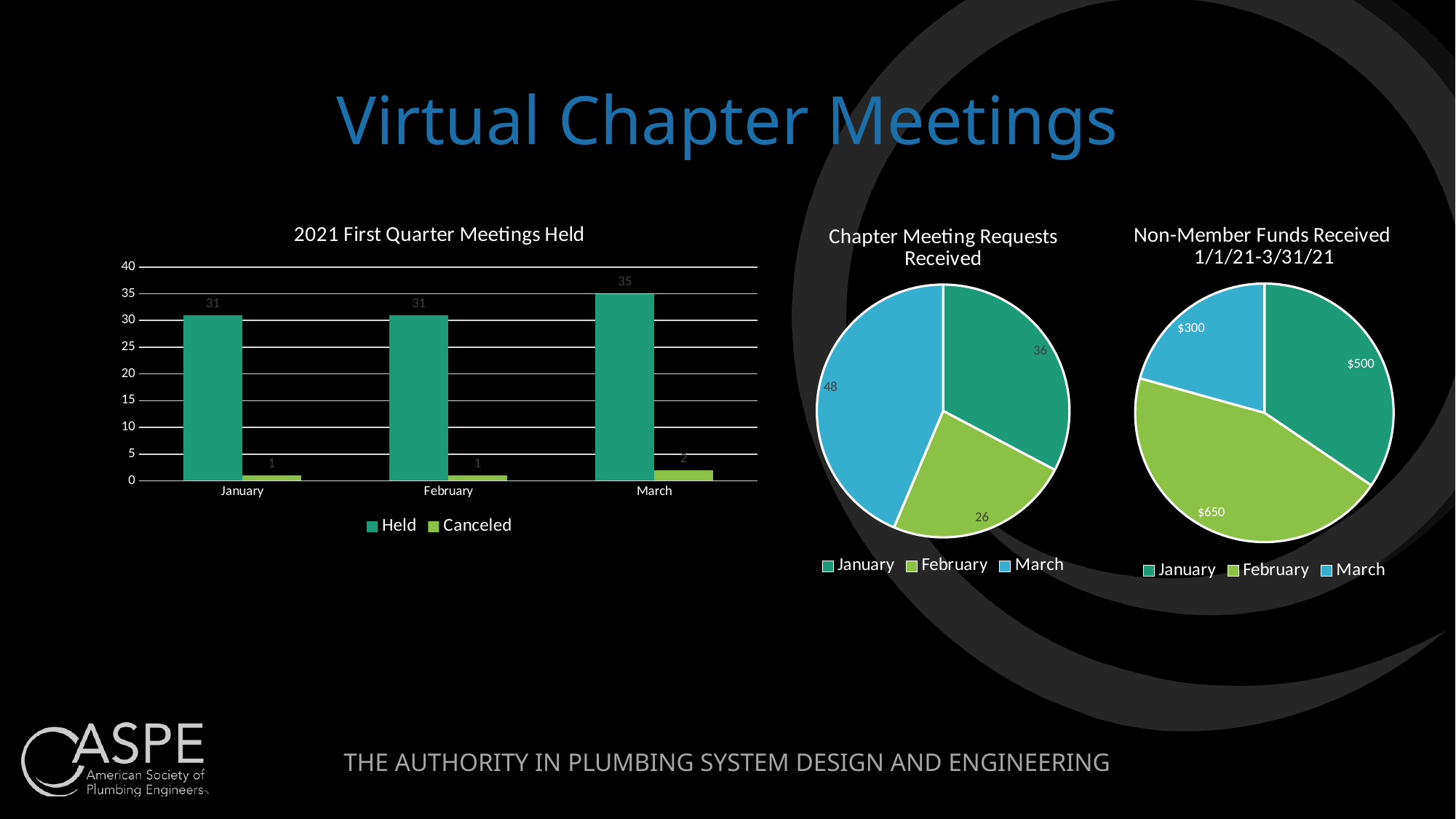
What kind of chart is '2021 First Quarter Meetings Held'? Bar chart In the 'Non-Member Funds Received 1/1/21-3/31/21' pie chart, how much was received in February? $650 In the 'Chapter Meeting Requests Received' pie chart, what is the difference between March and January requests? 12 In the 'Chapter Meeting Requests Received' pie chart, how many requests were received in March? 48 In the '2021 First Quarter Meetings Held' chart, how many series does the legend list? 2 In the '2021 First Quarter Meetings Held' chart, which month had the most meetings held? March In the '2021 First Quarter Meetings Held' chart, how many meetings were held in March? 35 How many charts are shown on the slide? 3 In the 'Chapter Meeting Requests Received' pie chart, which month had the fewest requests? February In the '2021 First Quarter Meetings Held' chart, how many meetings were canceled in February? 1 In the '2021 First Quarter Meetings Held' chart, what is the difference between meetings held in March and meetings held in January? 4 In the 'Non-Member Funds Received 1/1/21-3/31/21' pie chart, which is larger: January or March? January